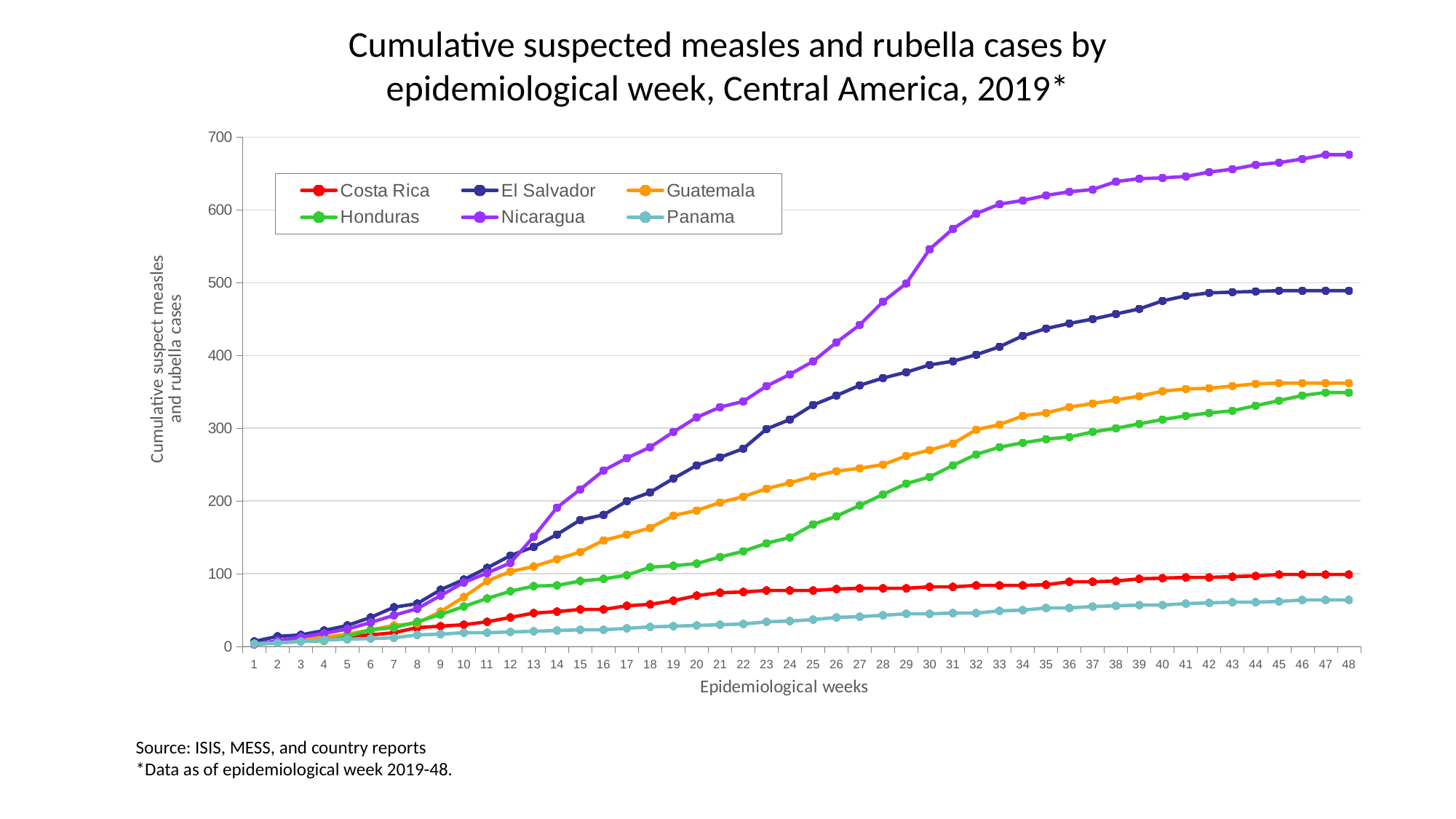
At week 48, which has more cumulative cases, El Salvador or Guatemala? El Salvador Is the value for El Salvador at week 48 greater or less than 500? less How many epidemiological weeks are plotted along the x axis? 48 Do the values for Nicaragua rise or fall across the epidemiological weeks? Rise What kind of chart is shown on the slide? Line chart What is the title of the chart? Cumulative suspected measles and rubella cases by epidemiological week, Central America, 2019* At week 48, which has more cumulative cases, Costa Rica or Panama? Costa Rica Is the value for Nicaragua at week 48 greater or less than 600? greater Is the value for Panama at week 48 greater or less than 100? less How many series does the legend list? 6 Which country has the highest cumulative number of cases at week 48? Nicaragua Which country has the lowest cumulative number of cases at week 48? Panama